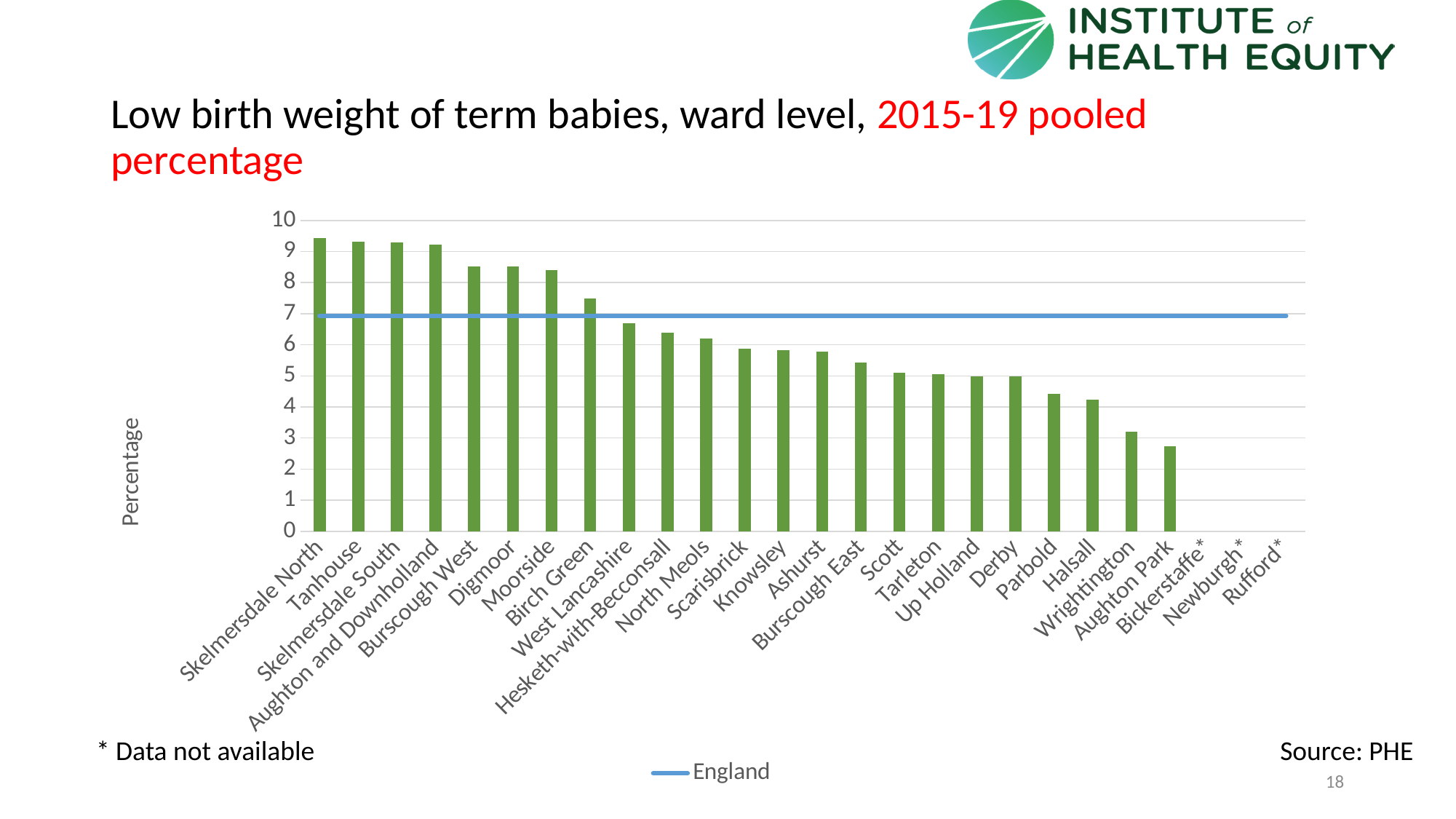
Is the value for Skelmersdale North greater or less than 9? greater What kind of chart is shown on the slide? combination bar and line chart (bars with a horizontal England line) Which ward has the lowest plotted value among those with data? Aughton Park How many wards are marked with an asterisk as data not available? 3 What series does the legend list? England Do the bar values rise or fall moving from left to right along the x axis? fall Is the value for Parbold greater or less than 5? less Is the value for West Lancashire greater or less than 7? less Which has the larger value, Digmoor or Halsall? Digmoor How many wards are listed on the x axis? 26